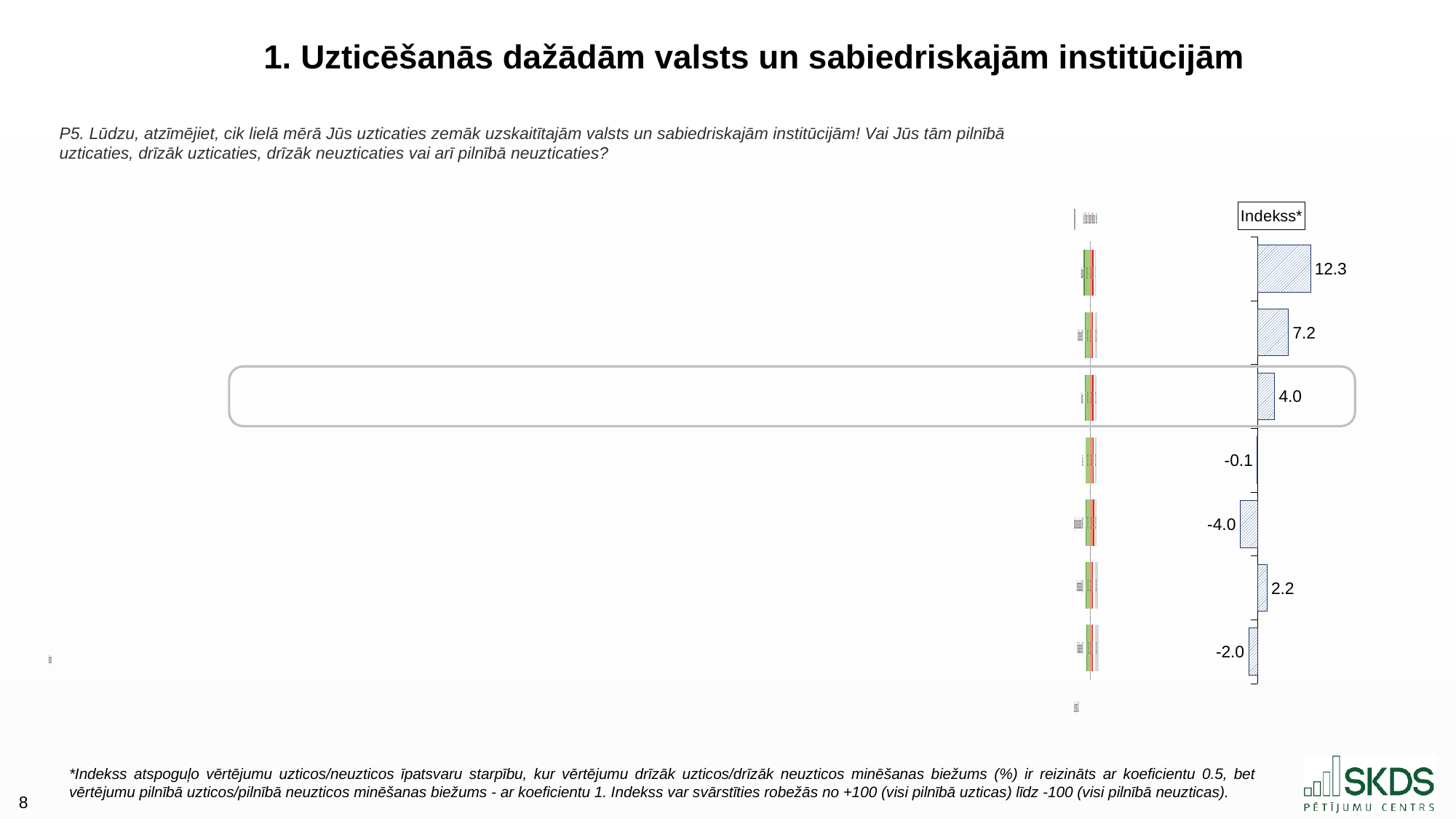
In the Indekss* chart, what is the value of the bar highlighted with a rounded outline (third from the top)? 4.0 How many bars are plotted in the Indekss* chart? 7 In the Indekss* chart, what is the highest index value shown? 12.3 In the Indekss* chart, what is the lowest index value shown? -4.0 In the Indekss* chart, what is the difference between the topmost bar (12.3) and the second bar (7.2)? 5.1 In the Indekss* chart, what is the value of the bottom bar? -2.0 In the Indekss* chart, how many bars have a negative value? 3 What kind of chart is the Indekss* chart? bar chart In the Indekss* chart, what is the value of the second bar from the top? 7.2 In the Indekss* chart, which is larger: the value of the sixth bar from the top (2.2) or the bottom bar (-2.0)? 2.2 What is the label shown in the box above the index bars? Indekss* In the Indekss* chart, what is the value of the topmost bar? 12.3